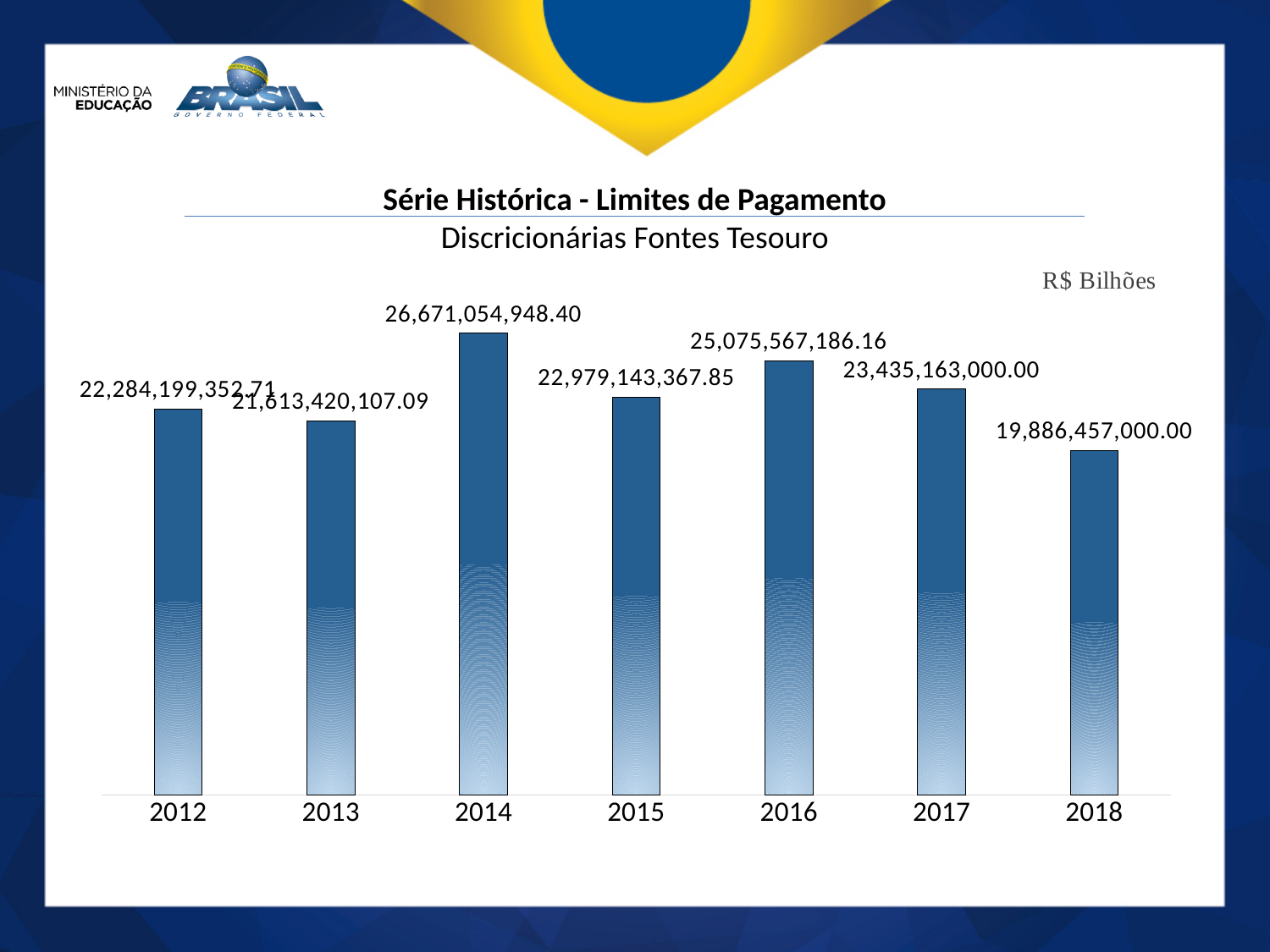
Which year has the lowest value? 2018 What is the value for 2017? 23,435,163,000.00 What is the difference between the values for 2017 and 2018? 3,548,706,000.00 What is the difference between the values for 2014 and 2018? 6,784,597,948.40 What is the value for 2016? 25,075,567,186.16 Which is larger, the value for 2016 or the value for 2015? 2016 How many years are shown on the x axis? 7 What is the value for 2018? 19,886,457,000.00 Which year has the highest value? 2014 What is the value for 2014? 26,671,054,948.40 Do the values rise or fall from 2016 to 2018? fall What kind of chart is this? bar chart